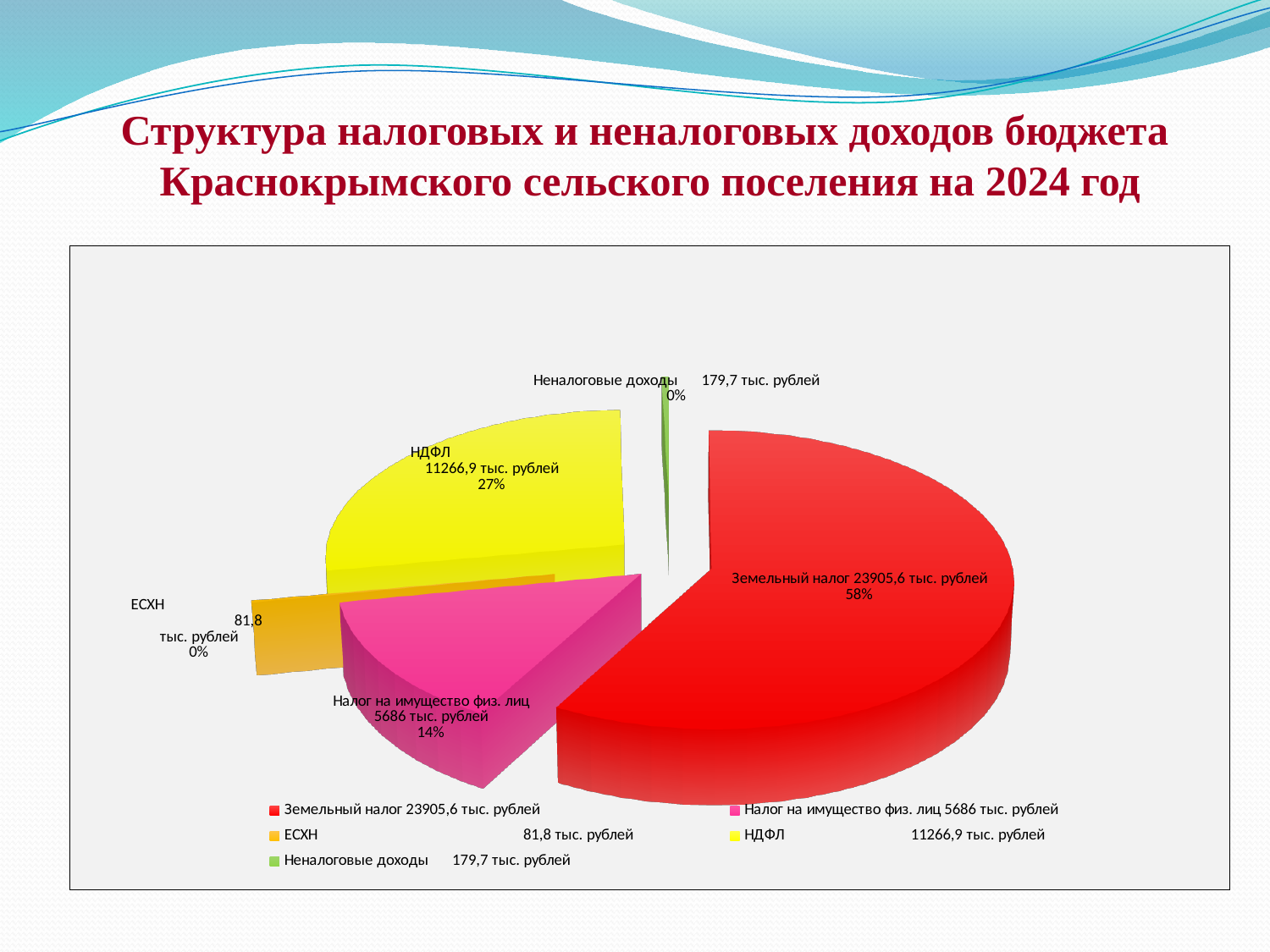
How many slices does the pie chart have? 5 What is the difference between the values for Земельный налог and НДФЛ? 12638,7 тыс. рублей What share of the pie does Земельный налог represent? 58% What share of the pie does Налог на имущество физ. лиц represent? 14% Which category has the smallest value in the chart? ЕСХН What kind of chart is shown on the slide? Pie chart Which is larger, the value for НДФЛ or the value for Налог на имущество физ. лиц? НДФЛ What is the value shown for Неналоговые доходы? 179,7 тыс. рублей Which category has the largest slice of the pie? Земельный налог What is the value shown for ЕСХН? 81,8 тыс. рублей What share of the pie does НДФЛ represent? 27% What colour is the slice for Земельный налог? Red